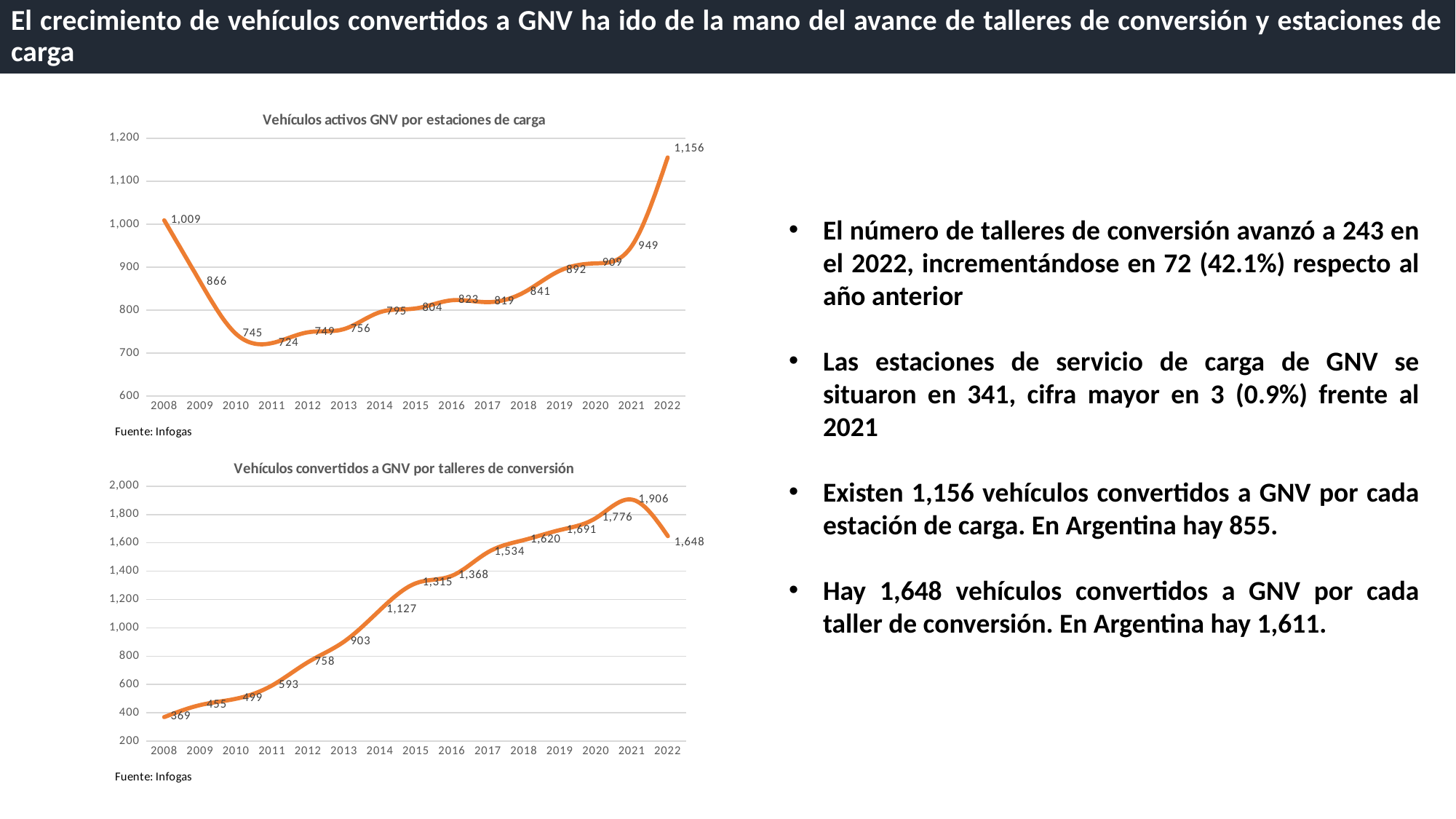
In the chart 'Vehículos convertidos a GNV por talleres de conversión', do the values generally rise or fall from 2008 to 2021? Rise In the chart 'Vehículos convertidos a GNV por talleres de conversión', which year has the highest value? 2021 In the chart 'Vehículos activos GNV por estaciones de carga', what is the difference between the 2022 value and the 2021 value? 207 What source is cited below both charts? Fuente: Infogas What kind of chart is 'Vehículos activos GNV por estaciones de carga'? Line chart In the chart 'Vehículos convertidos a GNV por talleres de conversión', what is the value for 2014? 1,127 In the chart 'Vehículos convertidos a GNV por talleres de conversión', what is the difference between the 2021 value and the 2022 value? 258 In the chart 'Vehículos activos GNV por estaciones de carga', which year has the lowest value? 2011 In the chart 'Vehículos activos GNV por estaciones de carga', what is the value for 2008? 1,009 In the chart 'Vehículos convertidos a GNV por talleres de conversión', is the value for 2012 larger or the value for 2013? 2013 In the chart 'Vehículos activos GNV por estaciones de carga', how many years are plotted? 15 In the chart 'Vehículos activos GNV por estaciones de carga', what is the value for 2022? 1,156